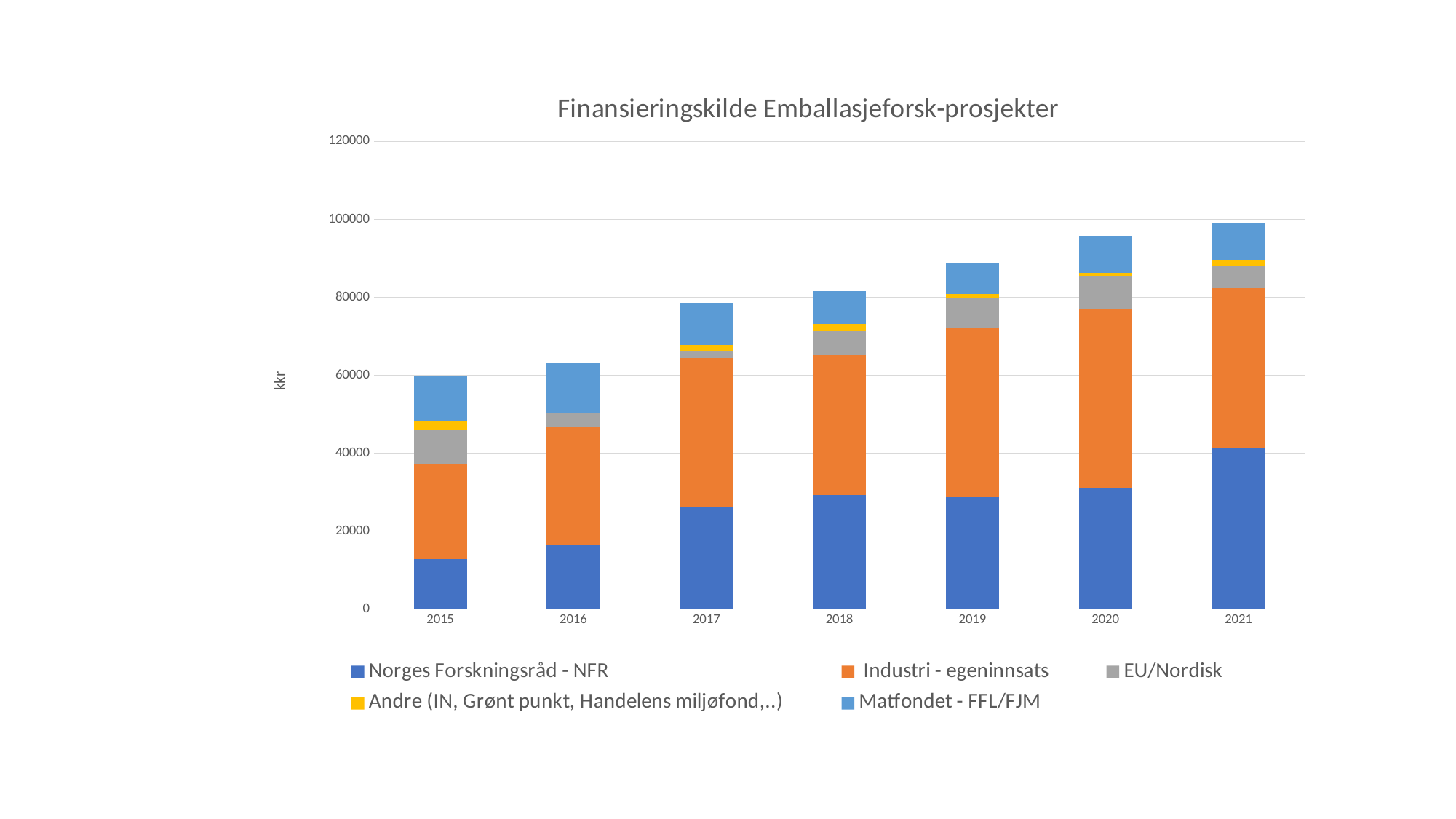
Is the total value for 2020 greater or less than 100000? less Is the total value for 2021 greater or less than 80000? greater Do the total bar heights rise or fall from 2015 to 2021? Rise Which year has the highest total stacked bar? 2021 How many years are shown on the x axis? 7 What is the title of the chart? Finansieringskilde Emballasjeforsk-prosjekter Which year has the lowest total stacked bar? 2015 How many series does the legend list? 5 What kind of chart is shown on the slide? Stacked bar chart Which year has the larger Norges Forskningsråd - NFR segment, 2015 or 2021? 2021 What label is shown on the vertical axis? kkr Is the total value for 2015 greater or less than 80000? less